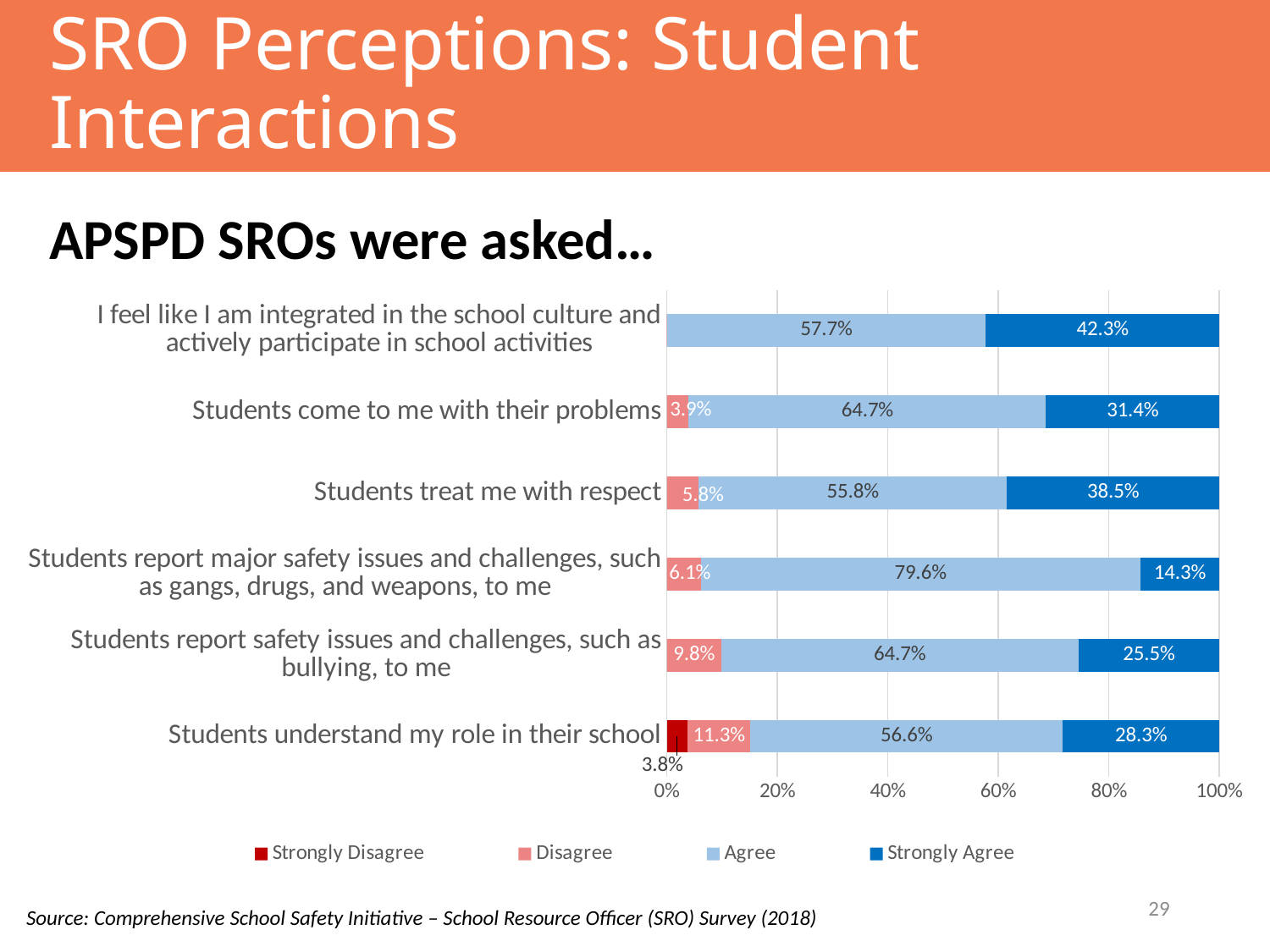
Which is larger: the Disagree percentage for "Students understand my role in their school" or for "Students treat me with respect"? Students understand my role in their school What percentage of SROs strongly disagreed with "Students understand my role in their school"? 3.8% How many statements are shown in the chart? 6 What type of chart is shown on the slide? Stacked bar chart Which statement has the highest Strongly Agree percentage? I feel like I am integrated in the school culture and actively participate in school activities What percentage of SROs disagreed with "Students report safety issues and challenges, such as bullying, to me"? 9.8% Which statement has the lowest Strongly Agree percentage? Students report major safety issues and challenges, such as gangs, drugs, and weapons, to me What is the difference between the Agree percentage and the Strongly Agree percentage for "Students come to me with their problems"? 33.3% What is the combined Agree and Strongly Agree percentage for "Students report safety issues and challenges, such as bullying, to me"? 90.2% What percentage of SROs agreed with "Students report major safety issues and challenges, such as gangs, drugs, and weapons, to me"? 79.6% What percentage of SROs strongly agreed with "Students treat me with respect"? 38.5% How many series does the legend list? 4